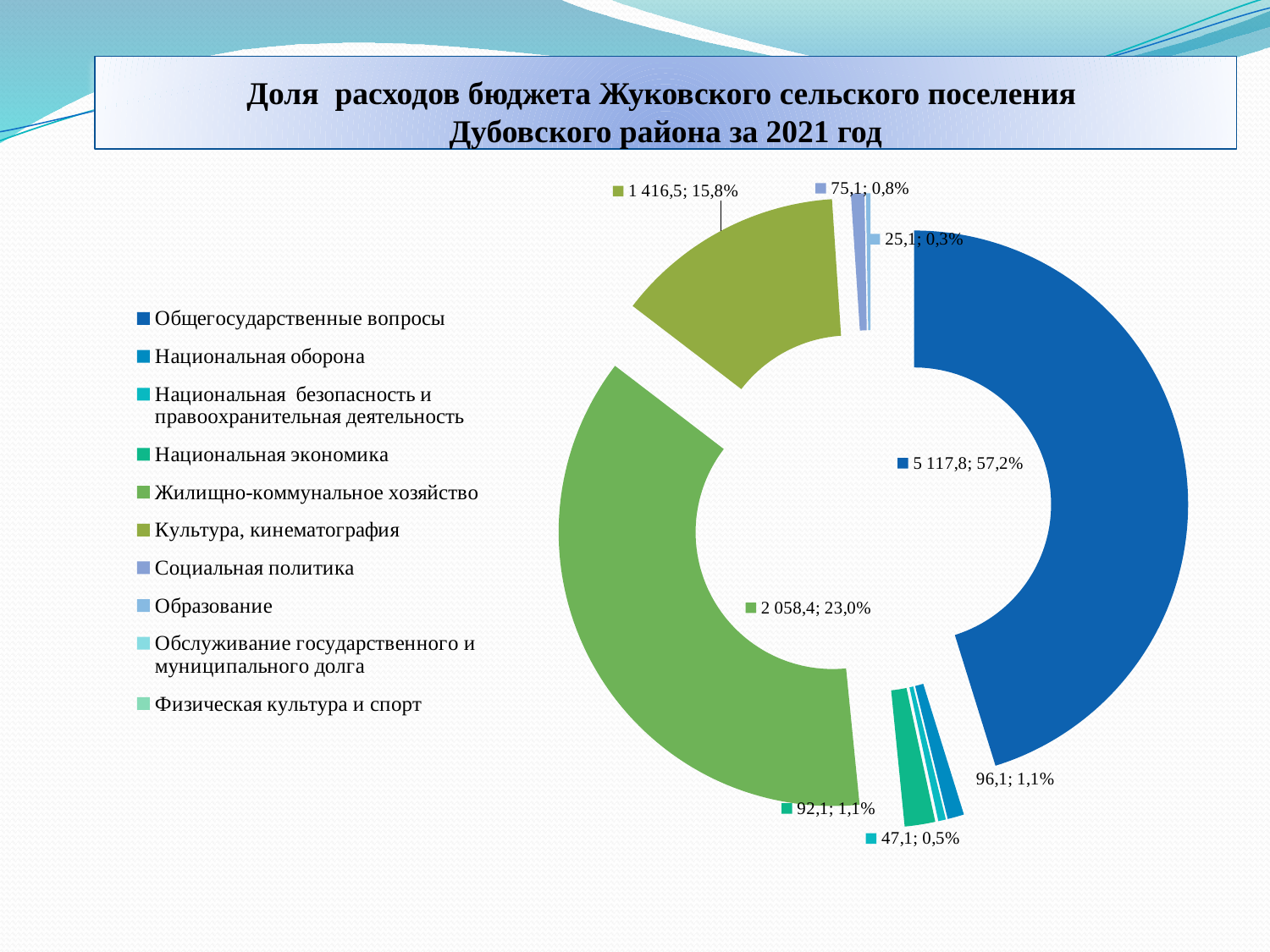
Which is larger: Жилищно-коммунальное хозяйство or Культура, кинематография? Жилищно-коммунальное хозяйство Which of the labelled slices has the smallest value? Образование (25,1; 0,3%) What share of the expenditures does Общегосударственные вопросы account for? 57,2% What is the value shown for Общегосударственные вопросы? 5 117,8 What share of the expenditures does Жилищно-коммунальное хозяйство account for? 23,0% What is the value shown for Культура, кинематография? 1 416,5 What share of the expenditures does Культура, кинематография account for? 15,8% What is the difference between the values for Общегосударственные вопросы and Жилищно-коммунальное хозяйство? 3 059,4 What kind of chart is shown on the slide? doughnut chart What is the value shown for Социальная политика? 75,1 Which category has the largest share of the budget expenditures? Общегосударственные вопросы How many categories does the legend list? 10